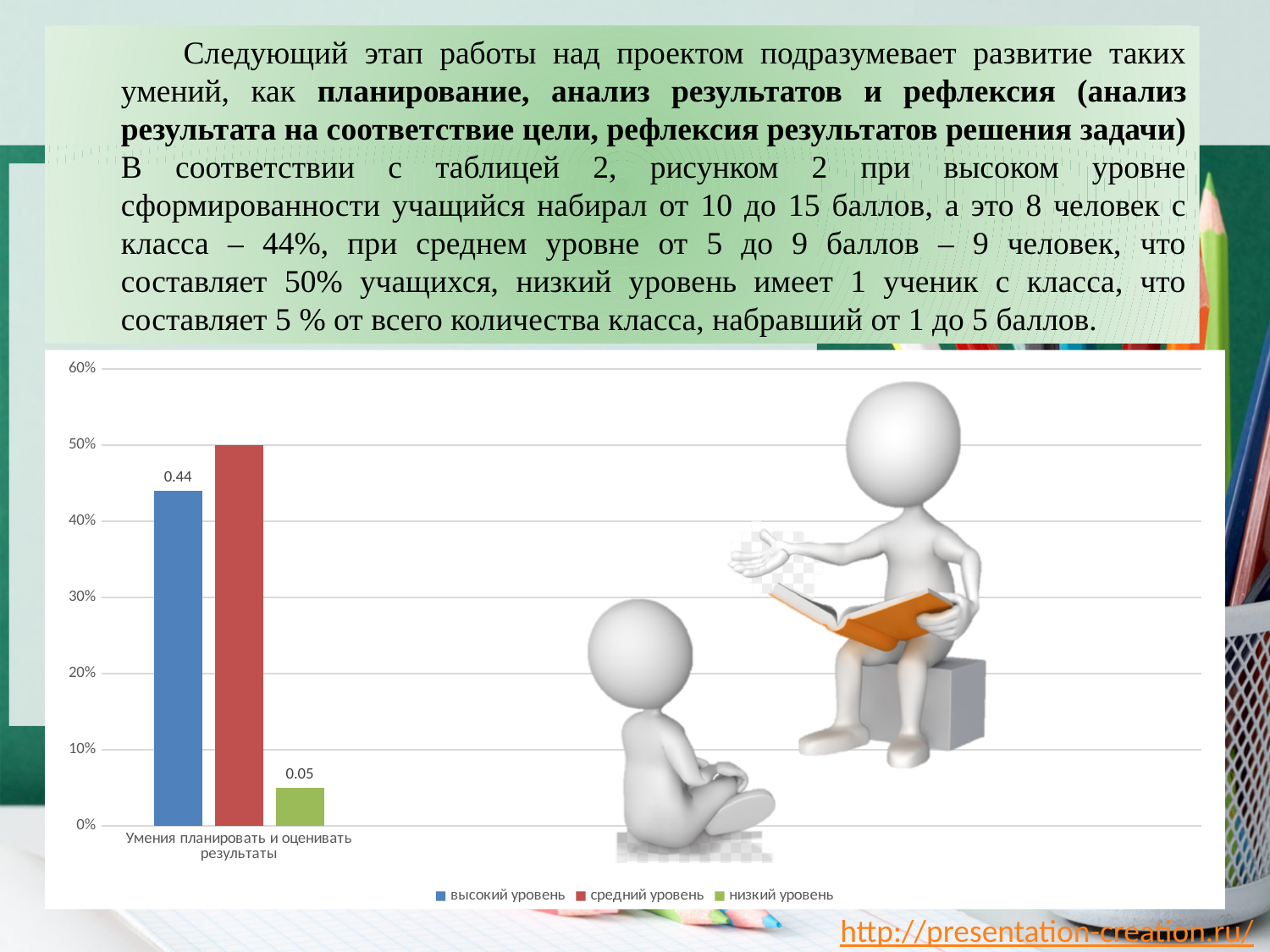
Is the value for средний уровень greater or less than 40%? greater Which series has the lowest bar in the chart? низкий уровень Which series has the highest bar in the chart? средний уровень How many categories are shown on the x axis of the chart? 1 What is the value for высокий уровень in the chart? 0.44 What colour is the bar for средний уровень? red What is the difference between the values for высокий уровень and низкий уровень? 0.39 What type of chart is shown on the slide? bar chart Is the value for низкий уровень greater or less than 10%? less What is the value for низкий уровень in the chart? 0.05 Which is larger, the bar for высокий уровень or the bar for средний уровень? средний уровень How many series does the legend list? 3